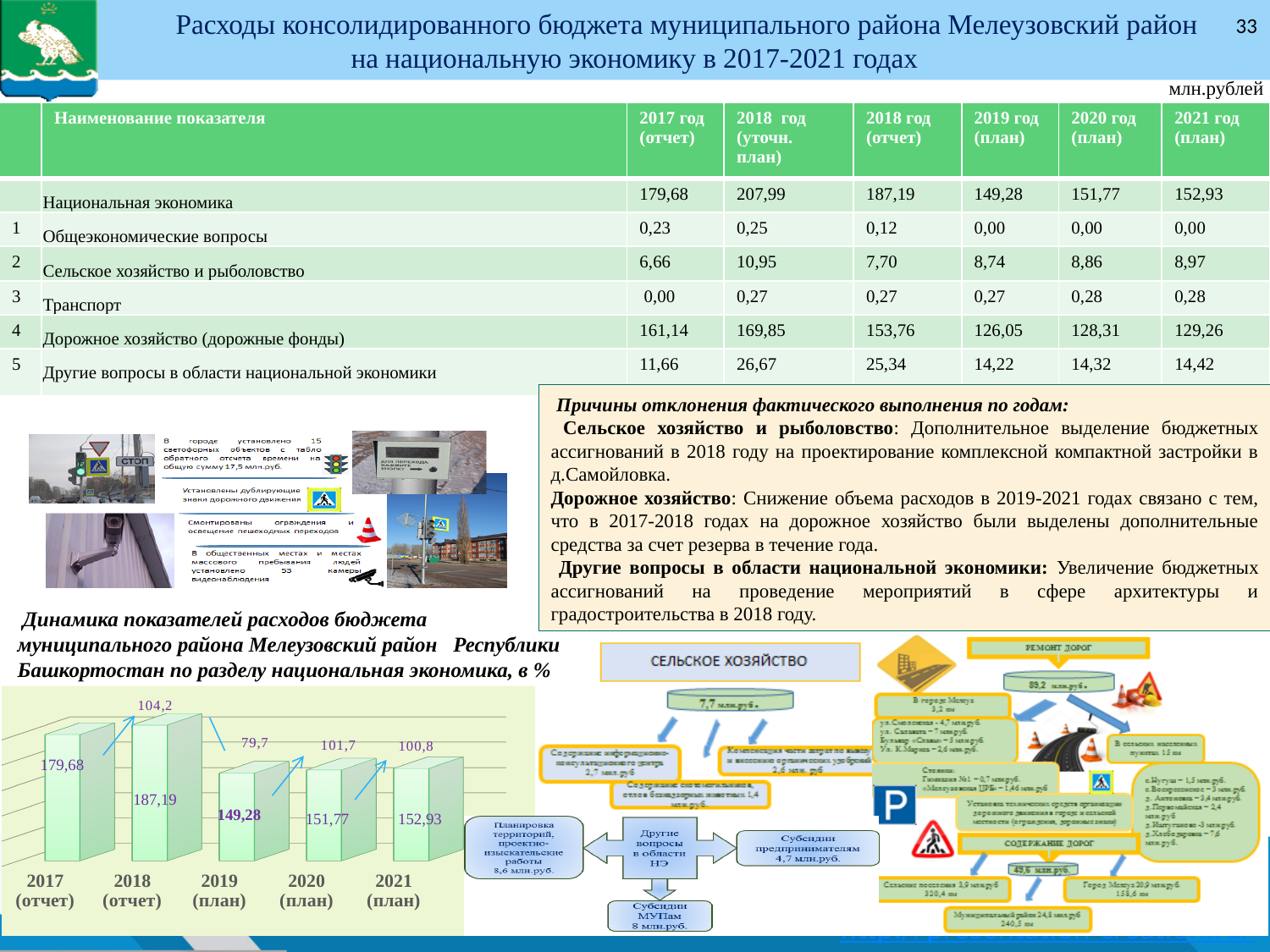
In the bar chart at the bottom left, which year has the lowest bar? 2019 (план) In the bar chart at the bottom left, what is the value for 2017 (отчет)? 179,68 In the bar chart at the bottom left, what is the value for 2021 (план)? 152,93 In the bar chart at the bottom left, which is larger: the value for 2017 (отчет) or the value for 2020 (план)? 2017 (отчет) What type of chart is shown at the bottom left of the slide? bar chart In the bar chart at the bottom left, how many years are shown on the x axis? 5 In the bar chart at the bottom left, which year has the highest bar? 2018 (отчет) In the bar chart at the bottom left, what is the value for 2019 (план)? 149,28 In the bar chart at the bottom left, do the bar values rise or fall from 2019 (план) to 2021 (план)? rise In the bar chart at the bottom left, what is the difference between the values for 2018 (отчет) and 2019 (план)? 37,91 In the bar chart at the bottom left, what is the value for 2018 (отчет)? 187,19 In the bar chart at the bottom left, what percentage label is shown on the line above the 2018 bar? 104,2